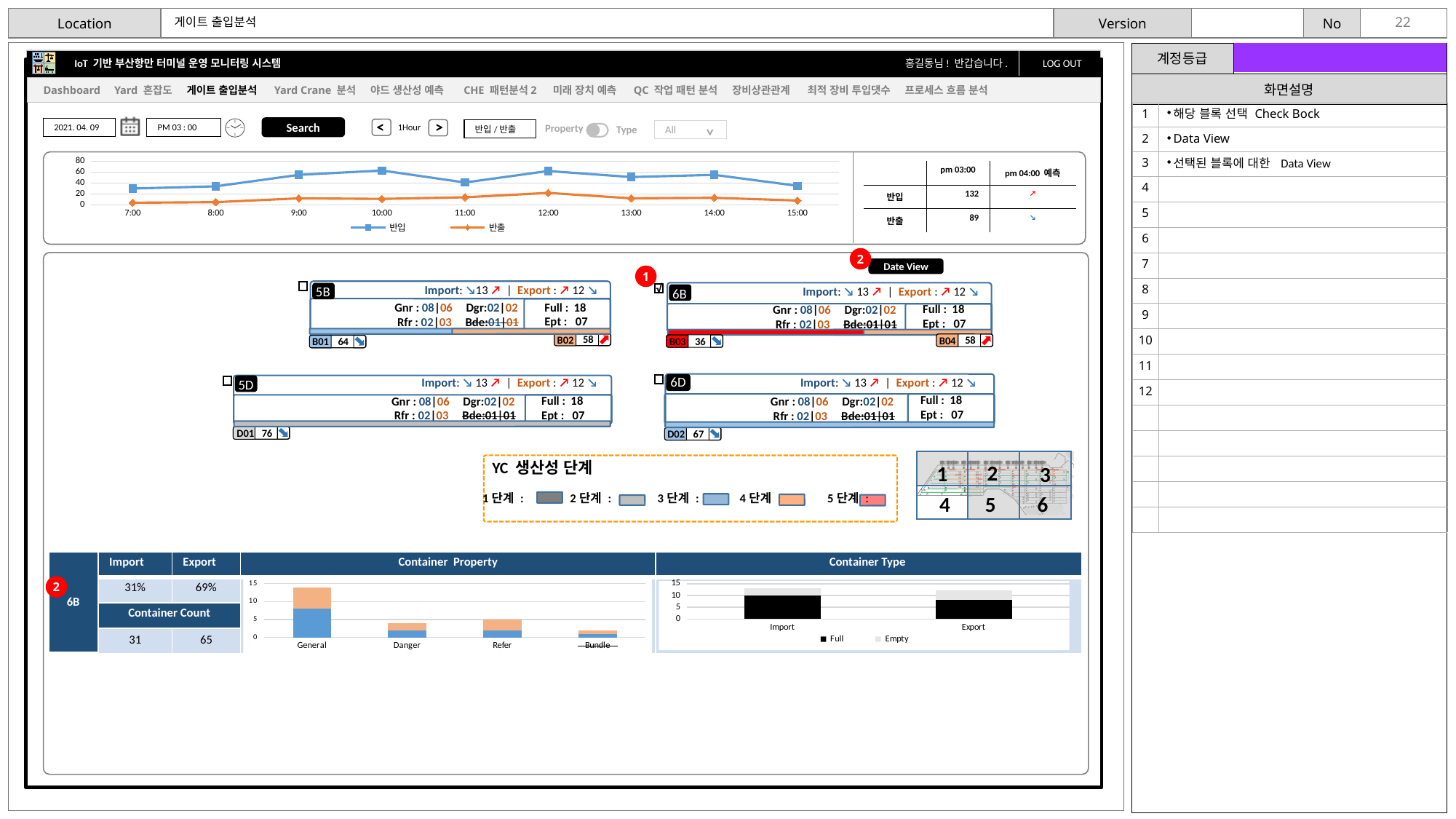
How many categories are shown on the x axis of the Container Property chart? 4 In the Container Property chart, which category has the shortest bar? Bundle How many time points are plotted on the x axis of the top line chart? 9 In the top line chart, is the value for 반출 at 7:00 greater or less than 20? less In the Container Property chart, is the total bar for General greater or less than 10? greater What kind of chart is the Container Property chart? bar chart What kind of chart is the top chart showing 반입 and 반출 over time? line chart How many series does the legend of the top line chart list? 2 In the top line chart, which series is higher at 12:00, 반입 or 반출? 반입 In the top line chart, is the value for 반입 at 7:00 greater or less than 40? less In the Container Property chart, which category has the tallest bar? General What are the two legend entries of the Container Type chart? Full, Empty